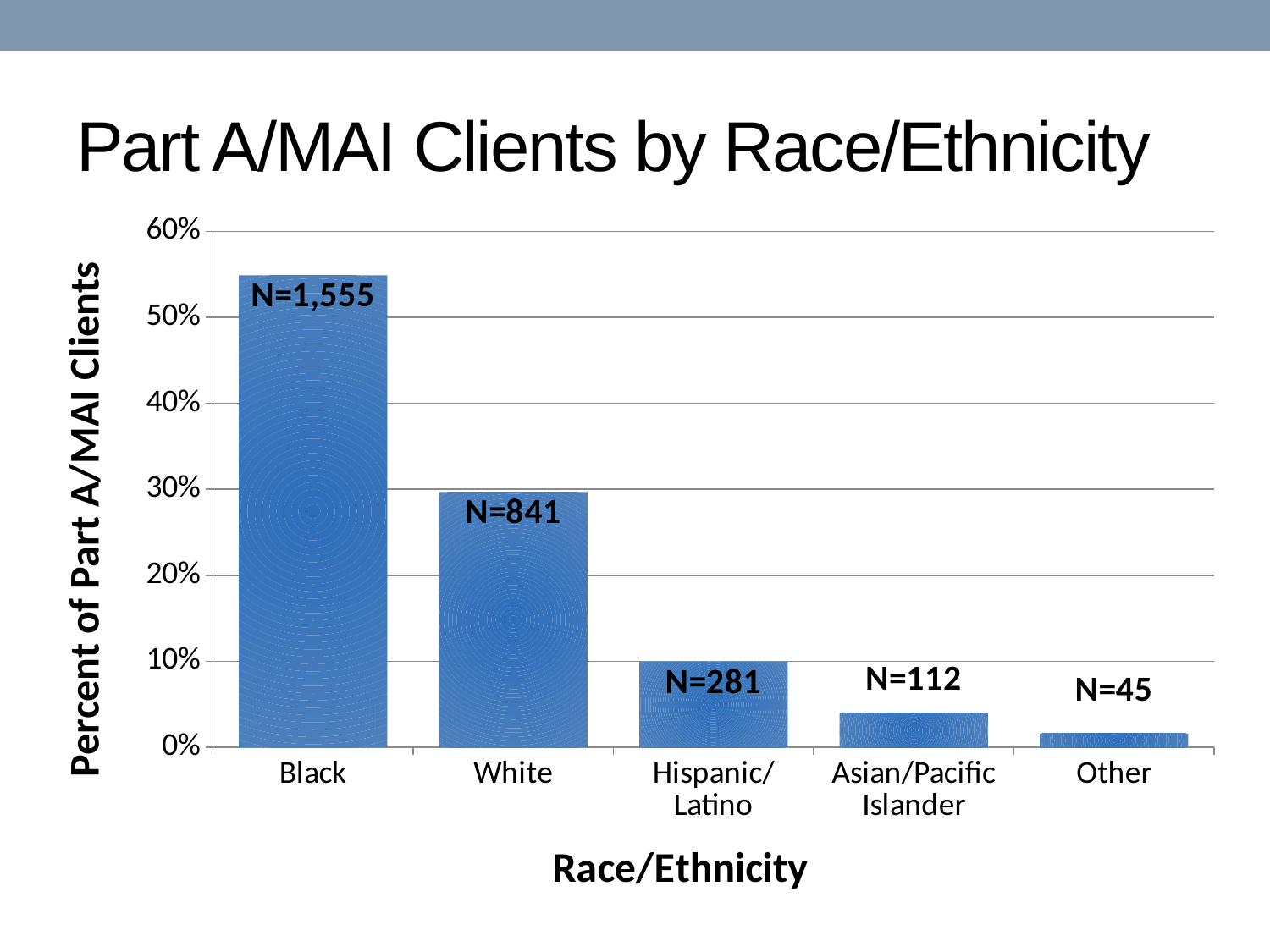
Which race/ethnicity category has the lowest percent of Part A/MAI clients? Other What is the N value shown for the Other category? N=45 What type of chart is shown on the slide? Bar chart How many race/ethnicity categories are shown on the chart? 5 What is the N value shown for the White category? N=841 What is the N value shown for the Asian/Pacific Islander category? N=112 Is the percent of Part A/MAI clients for Black greater or less than 50%? greater Is the percent of Part A/MAI clients for Asian/Pacific Islander greater or less than 10%? less What is the N value shown for the Hispanic/Latino category? N=281 Which race/ethnicity category has the highest percent of Part A/MAI clients? Black What is the N value shown for the Black category? N=1,555 Which has a higher percent of Part A/MAI clients, White or Hispanic/Latino? White